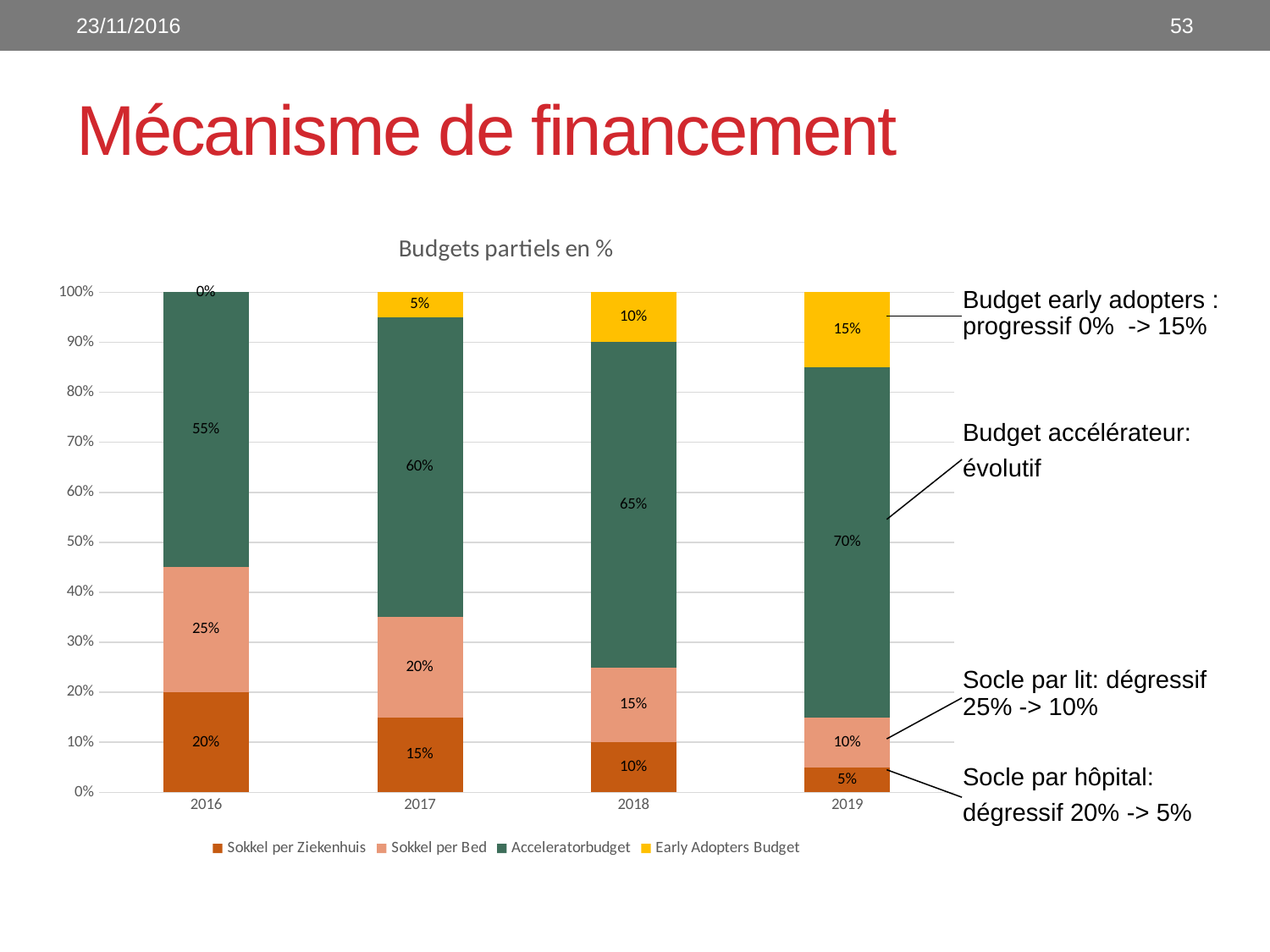
What is the difference between the Acceleratorbudget value in 2019 and in 2016? 15% In which year is the Sokkel per Ziekenhuis share lowest? 2019 What kind of chart is shown? Stacked bar chart Does the Early Adopters Budget share rise or fall from 2016 to 2019? Rise What is the value for Sokkel per Bed in 2017? 20% How many series does the legend list? 4 Which is larger in 2018: Sokkel per Bed or Early Adopters Budget? Sokkel per Bed What is the value for Sokkel per Ziekenhuis in 2016? 20% In which year is the Acceleratorbudget share highest? 2019 How many years are shown on the x axis? 4 What is the value for Acceleratorbudget in 2018? 65% What is the value for Early Adopters Budget in 2019? 15%